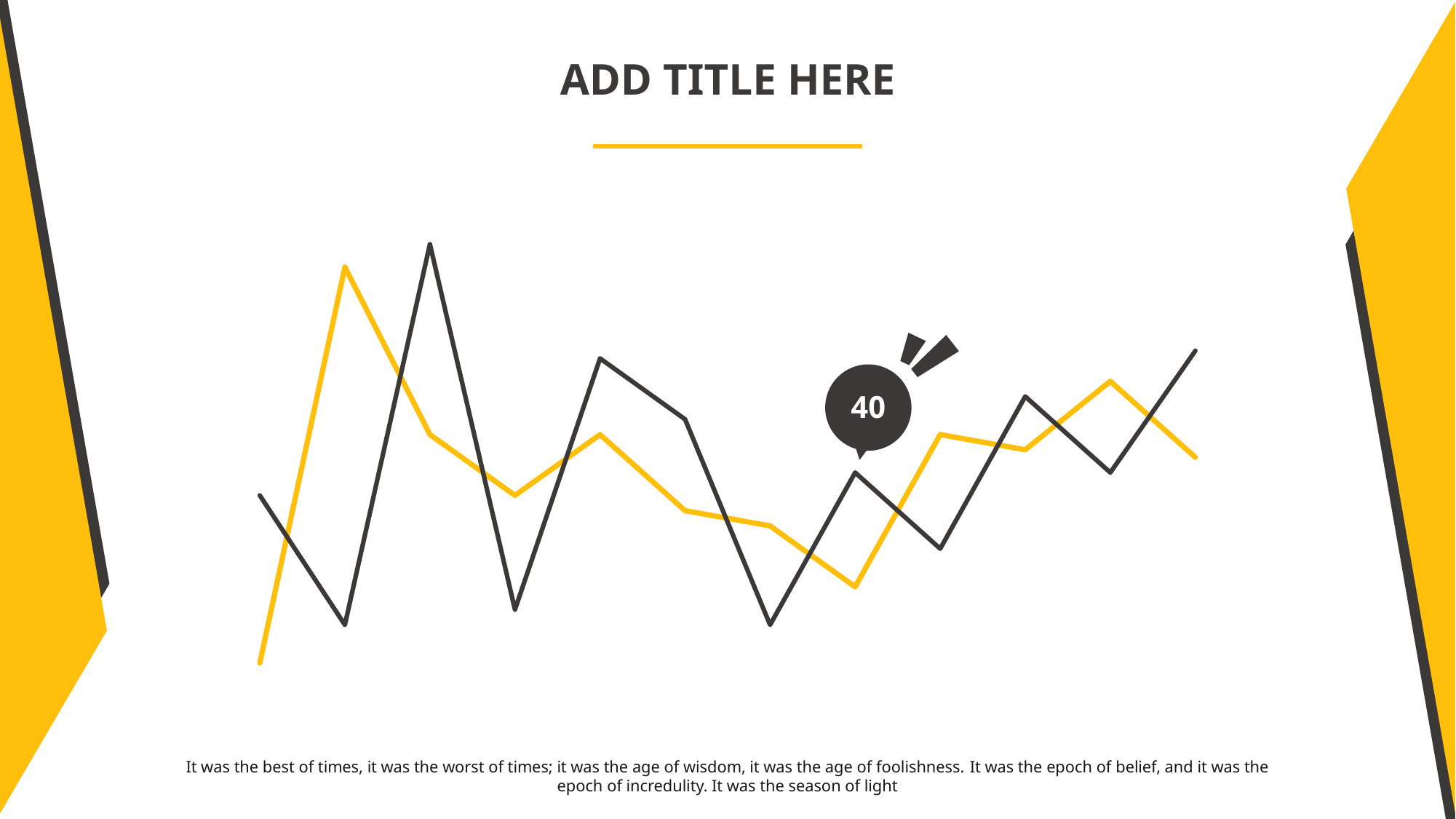
At the rightmost point of the chart, which line is higher, the yellow line or the dark line? the dark line Which line does the callout labelled 40 point to, the yellow line or the dark line? the dark line Which line reaches the lowest point on the chart, the yellow line or the dark line? the yellow line How many data points does the dark line have? 12 At the leftmost point of the chart, which line is higher, the yellow line or the dark line? the dark line Does the dark line rise or fall between its first and second points? fall How many lines are plotted on the chart? 2 How many data points does the yellow line have? 12 What is the title shown above the chart? ADD TITLE HERE What value is printed in the callout label on the chart? 40 What kind of chart is shown on the slide? line chart Does the yellow line rise or fall between its first and second points? rise